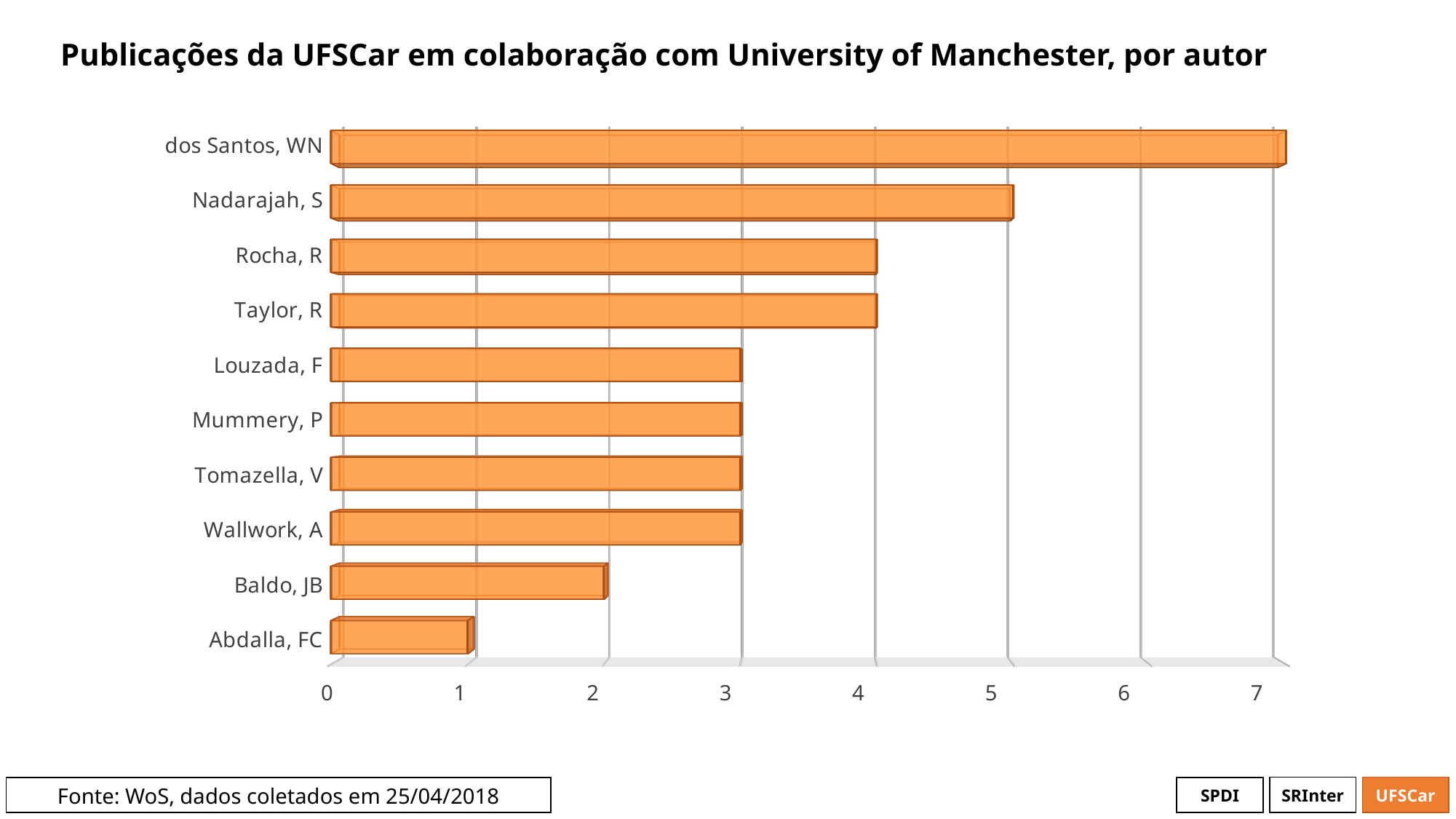
What kind of chart is shown on the slide? bar chart What is the title of the chart? Publicações da UFSCar em colaboração com University of Manchester, por autor How many publications does dos Santos, WN have? 7 What is the difference in publications between dos Santos, WN and Nadarajah, S? 2 Is the value for Nadarajah, S greater or less than 4? greater Which author has the highest number of publications? dos Santos, WN Is the value for Abdalla, FC greater or less than 2? less Which author has the lowest number of publications? Abdalla, FC How many publications does Baldo, JB have? 2 Who has more publications, Rocha, R or Louzada, F? Rocha, R How many publications does Nadarajah, S have? 5 How many authors are listed on the chart? 10